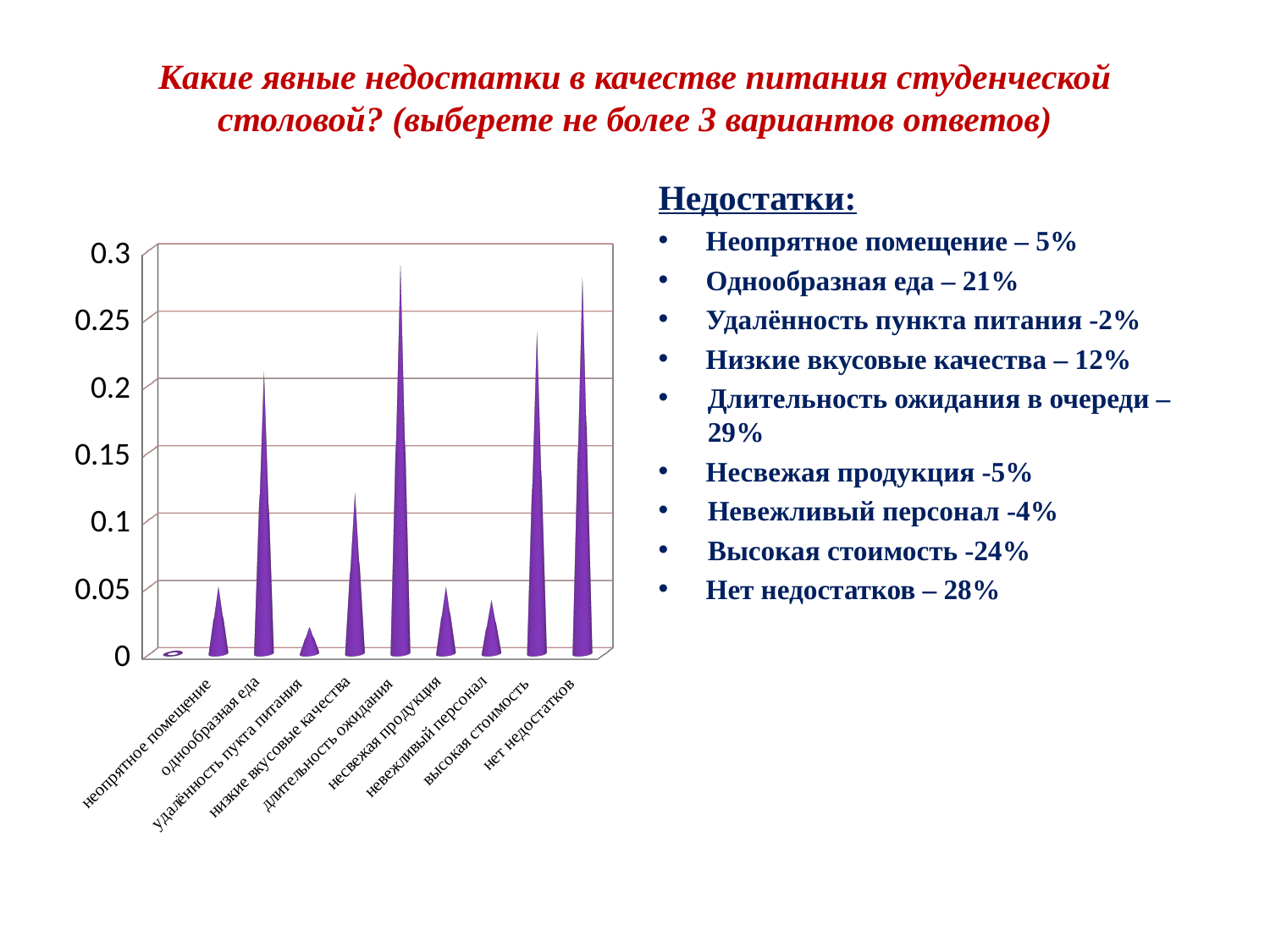
What kind of chart is shown on the slide? bar chart How many categories are plotted on the x axis of the chart? 9 Is the value for удалённость пункта питания greater or less than 0.05? less Is the value for низкие вкусовые качества greater or less than 0.1? greater Is the value for длительность ожидания greater or less than 0.25? greater Which category has the lowest value in the chart? удалённость пукта питания What colour are the bars in the chart? purple Which is larger, the value for высокая стоимость or the value for однообразная еда? высокая стоимость Which is larger, the value for низкие вкусовые качества or the value for невежливый персонал? низкие вкусовые качества